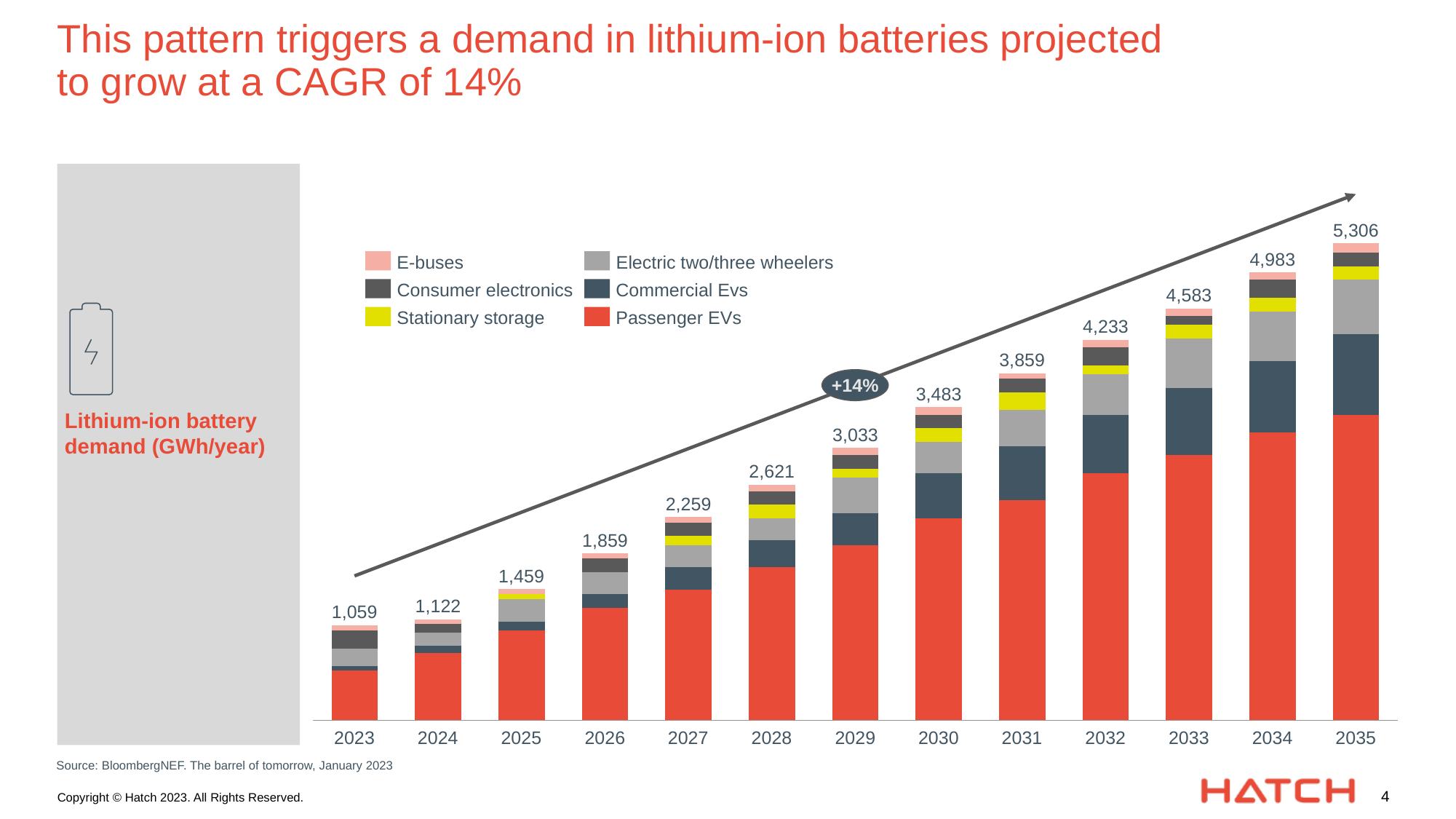
Which year has the highest total lithium-ion battery demand? 2035 What is the difference between the total demand in 2035 and the total demand in 2023? 4,247 Does total lithium-ion battery demand rise or fall from 2023 to 2035? Rise What is the difference between the total demand in 2030 and in 2029? 450 What kind of chart is used to show lithium-ion battery demand? Stacked bar chart What is the total value labelled above the 2029 bar? 3,033 Which year has a larger total demand, 2027 or 2031? 2031 Which year has the lowest total lithium-ion battery demand? 2023 What is the total lithium-ion battery demand shown for 2023? 1,059 What is the total lithium-ion battery demand shown for 2035? 5,306 How many series does the chart legend list? 6 How many years are shown on the x axis of the chart? 13